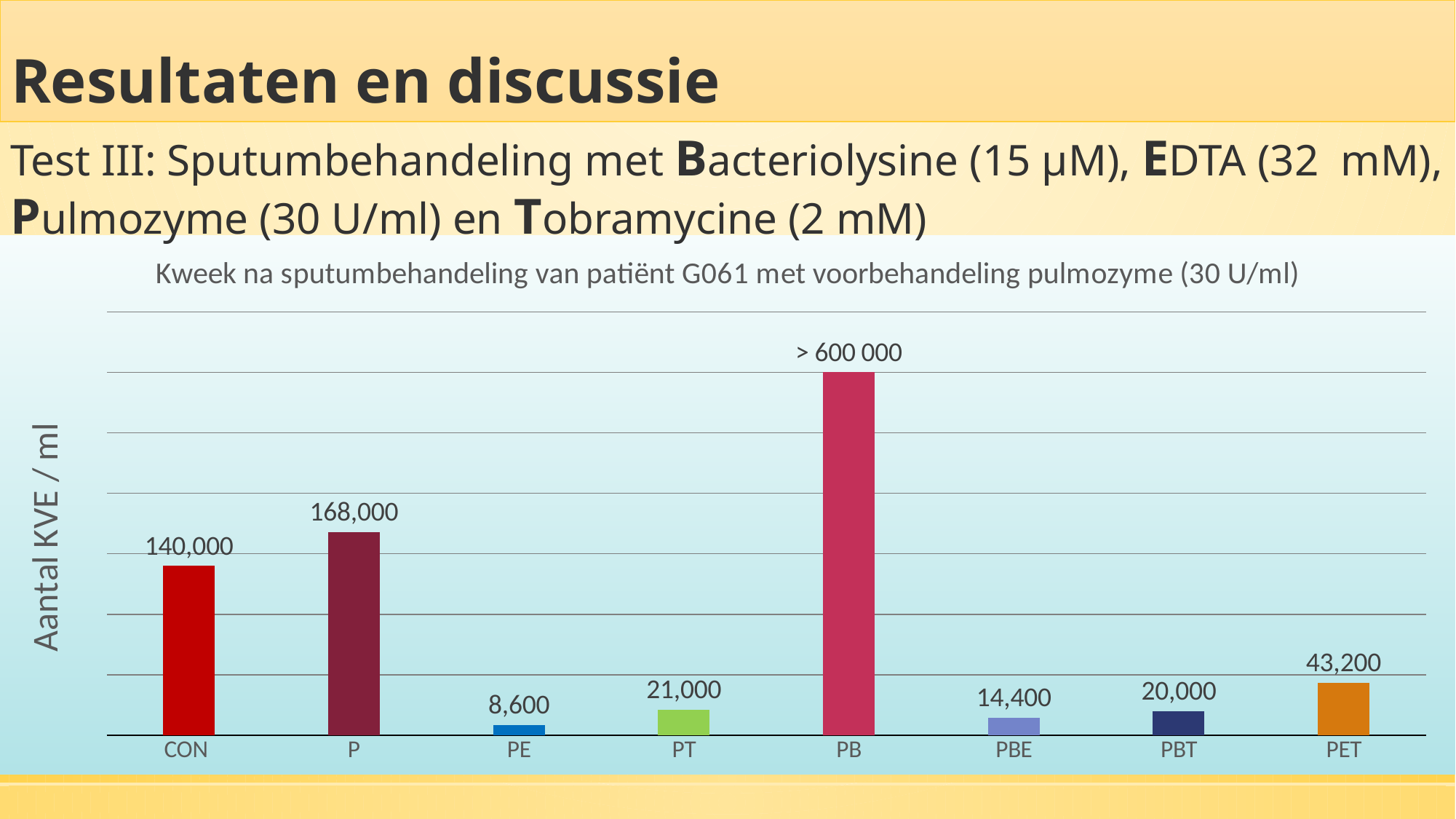
What is the difference between the values for PET and PBE? 28,800 What is the value for PE? 8,600 What is the value for P? 168,000 What is the label of the y axis? Aantal KVE / ml What is the data label shown for PB? > 600 000 What is the value for PET? 43,200 What is the value for CON? 140,000 Which category has the highest value? PB Which is larger, the value for PT or the value for PBT? PT How many categories are shown on the x axis? 8 Which category has the lowest value? PE What is the difference between the values for P and CON? 28,000